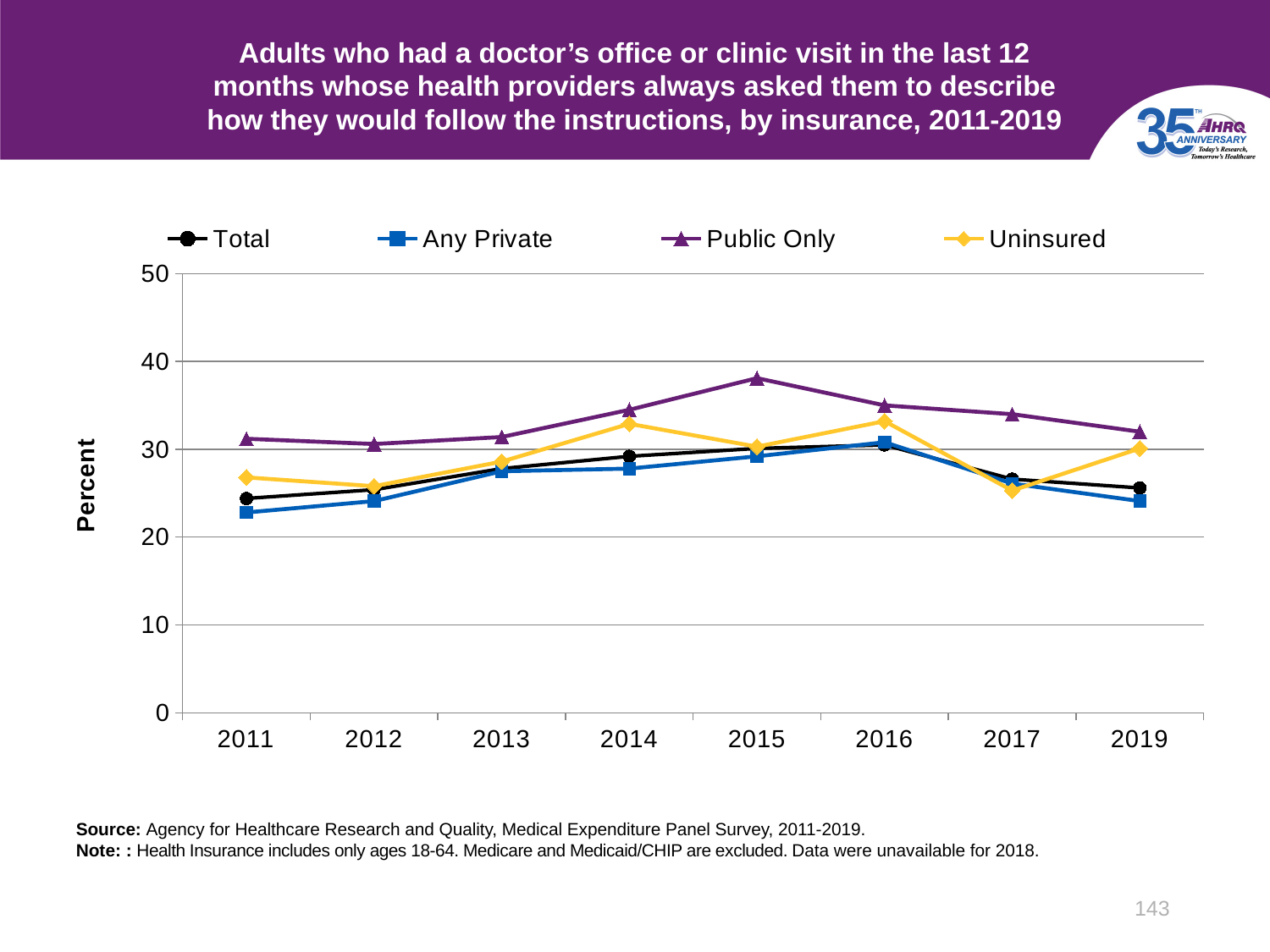
Which is larger in 2011, the value for Public Only or the value for Any Private? Public Only Which series has the lowest value in 2011? Any Private What kind of chart is shown on the slide? Line chart Is the value for Uninsured in 2014 greater or less than 30? greater Is the value for Any Private in 2011 greater or less than 30? less Does the Public Only series rise or fall from 2011 to 2015? Rise Is the value for Public Only in 2015 greater or less than 40? less What is the label on the y axis? Percent In which year does the Public Only series reach its highest value? 2015 How many years are plotted along the x axis? 8 Which is larger in 2019, the value for Uninsured or the value for Total? Uninsured How many series does the legend list? 4